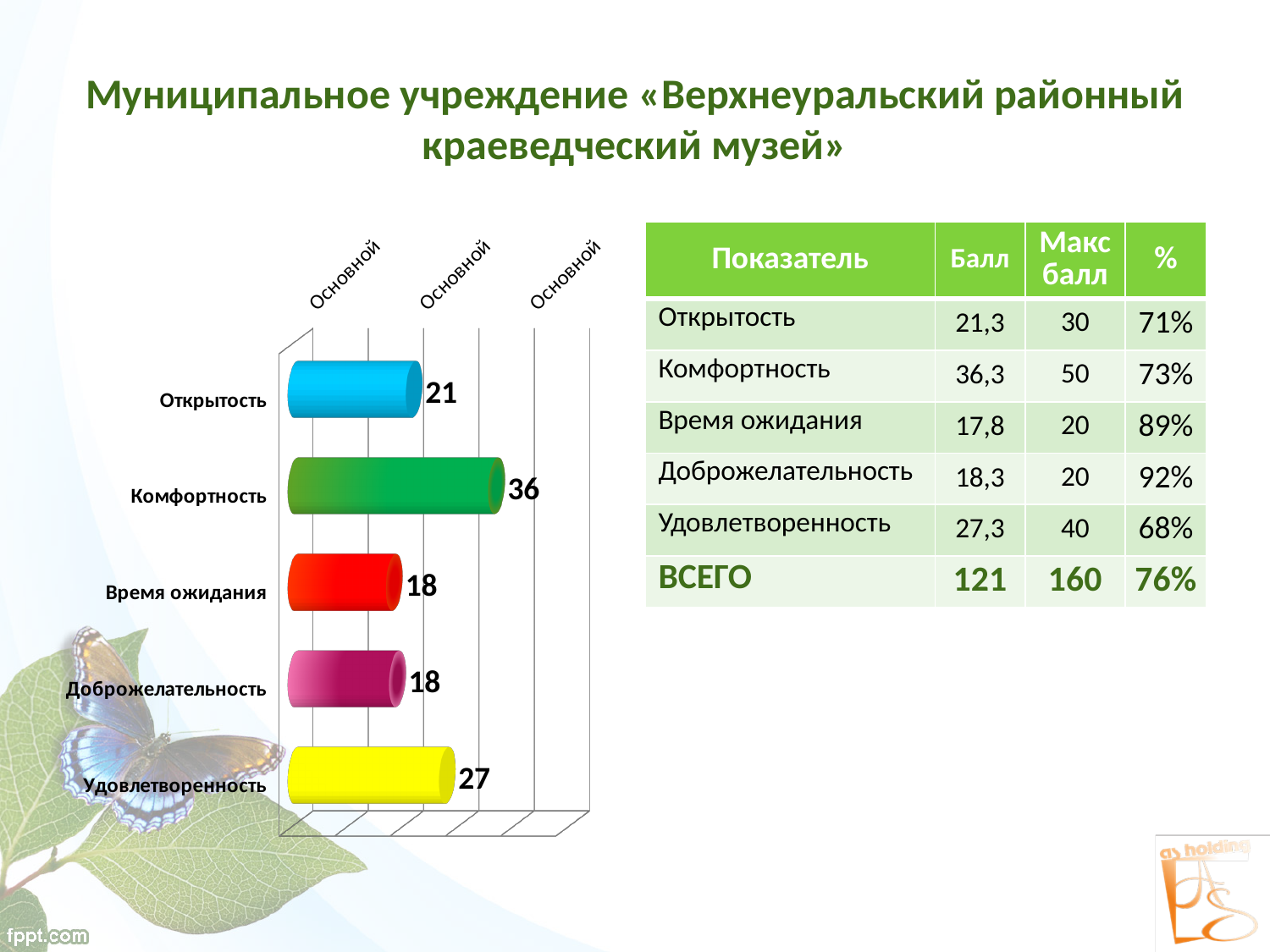
What is the difference between the values for Комфортность and Открытость in the chart? 15 Which is larger in the chart, the value for Удовлетворенность or the value for Открытость? Удовлетворенность How many categories are shown in the chart? 5 What value does the chart show for Время ожидания? 18 What kind of chart is shown on the slide? Bar chart Which category has the highest value in the chart? Комфортность What value does the chart show for Комфортность? 36 What value does the chart show for Открытость? 21 What colour is the bar for Удовлетворенность in the chart? Yellow What is the difference between the values for Удовлетворенность and Доброжелательность in the chart? 9 What value does the chart show for Удовлетворенность? 27 What colour is the bar for Комфортность in the chart? Green